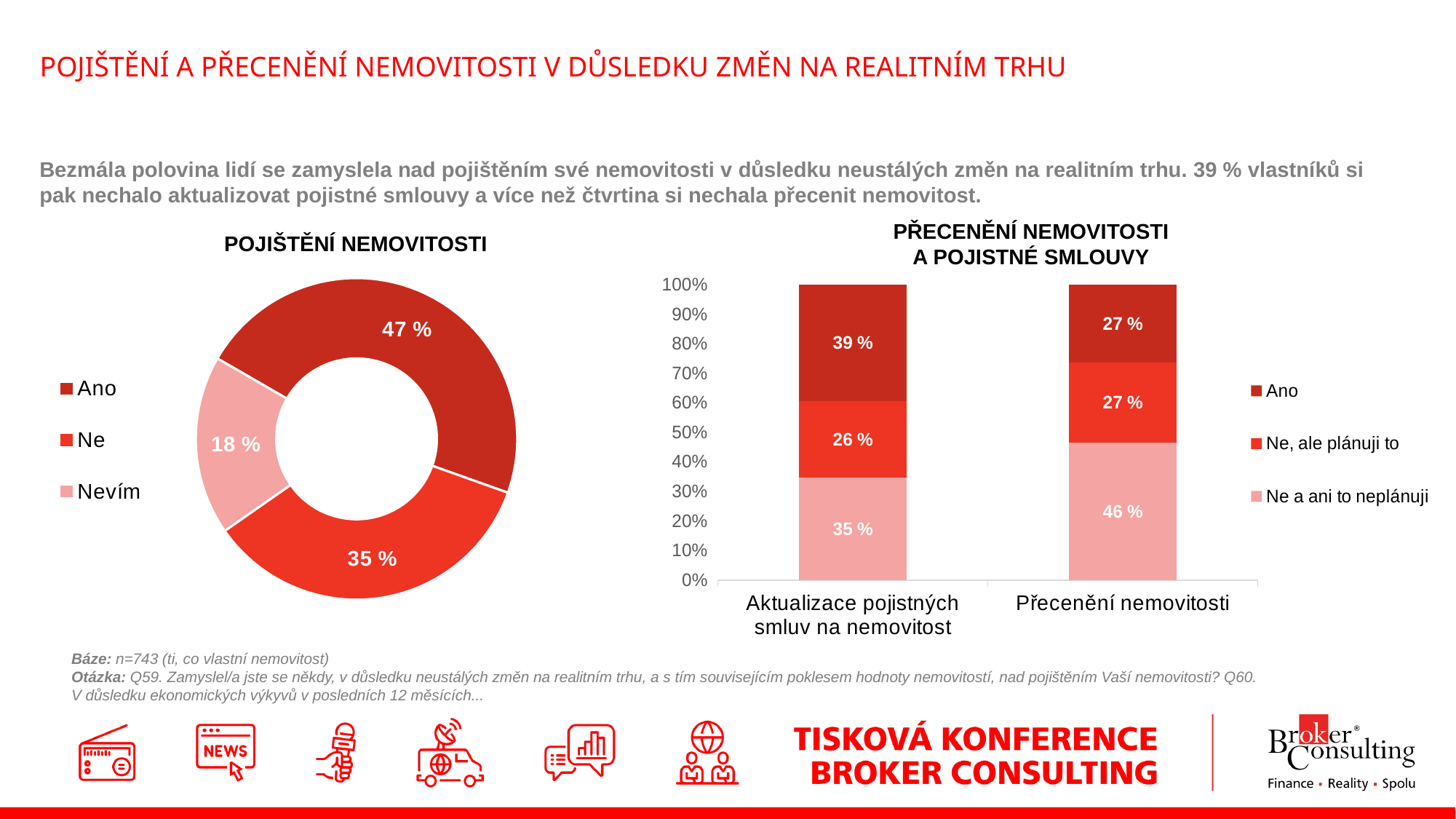
How many series does the legend of the 'PŘECENĚNÍ NEMOVITOSTI A POJISTNÉ SMLOUVY' chart list? 3 In the 'POJIŠTĚNÍ NEMOVITOSTI' chart, which answer has the largest share? Ano In the 'PŘECENĚNÍ NEMOVITOSTI A POJISTNÉ SMLOUVY' chart, what is the 'Ano' value for 'Aktualizace pojistných smluv na nemovitost'? 39 % In the 'POJIŠTĚNÍ NEMOVITOSTI' chart, what share of respondents answered 'Ano'? 47 % What kind of chart is the 'PŘECENĚNÍ NEMOVITOSTI A POJISTNÉ SMLOUVY' chart? Stacked bar chart In the 'PŘECENĚNÍ NEMOVITOSTI A POJISTNÉ SMLOUVY' chart, what is the 'Ne a ani to neplánuji' value for 'Přecenění nemovitosti'? 46 % In the 'PŘECENĚNÍ NEMOVITOSTI A POJISTNÉ SMLOUVY' chart, which category has the larger 'Ano' value? Aktualizace pojistných smluv na nemovitost In the 'POJIŠTĚNÍ NEMOVITOSTI' chart, which answer has the smallest share? Nevím What kind of chart is the 'POJIŠTĚNÍ NEMOVITOSTI' chart? Doughnut (pie) chart In the 'POJIŠTĚNÍ NEMOVITOSTI' chart, what is the difference between the 'Ano' and 'Ne' shares? 12 % In the 'PŘECENĚNÍ NEMOVITOSTI A POJISTNÉ SMLOUVY' chart, what is the difference between the 'Ne a ani to neplánuji' values for the two categories? 11 % In the 'POJIŠTĚNÍ NEMOVITOSTI' chart, what share of respondents answered 'Nevím'? 18 %